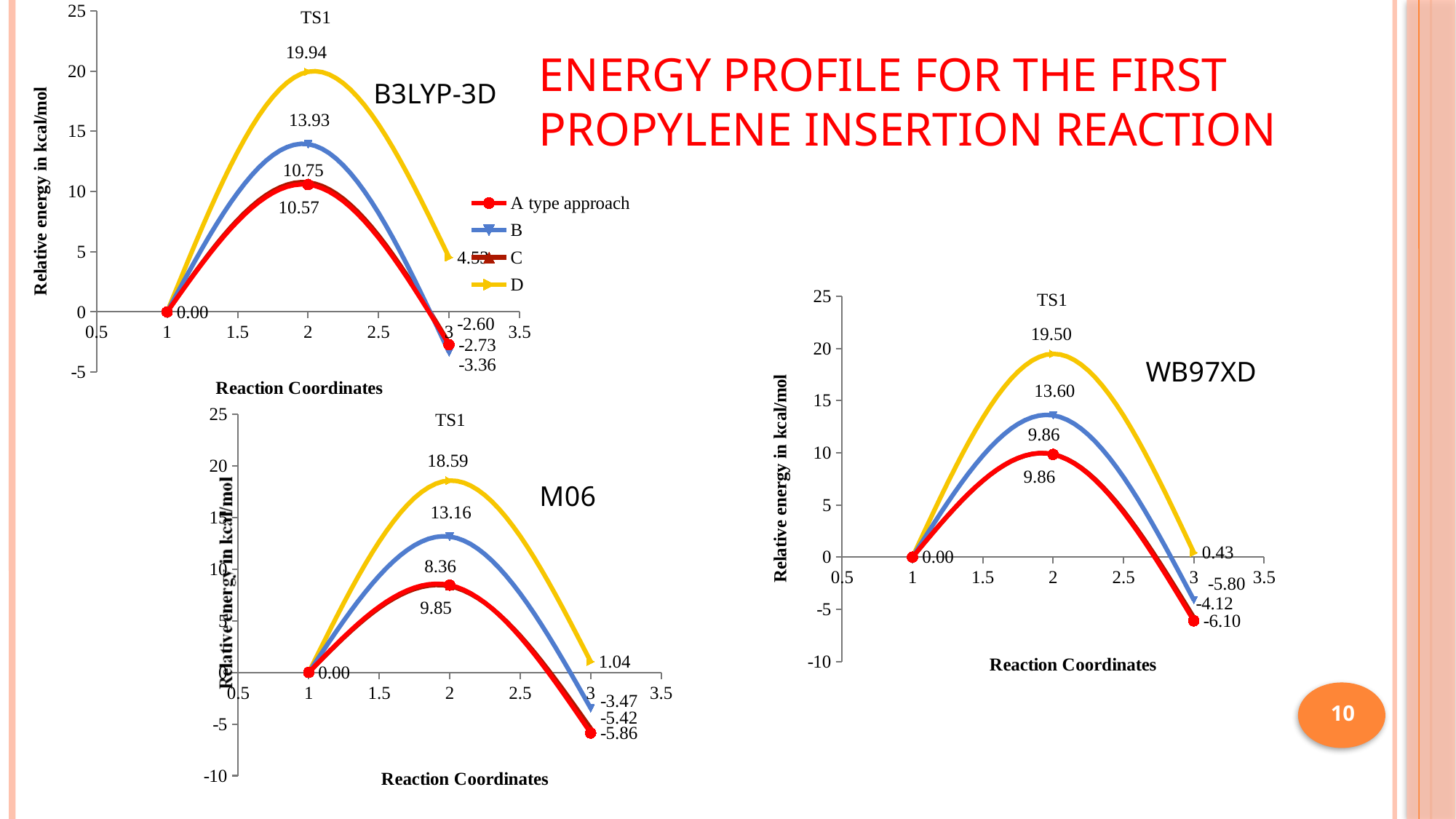
In the WB97XD chart, what is the relative energy of the D series at reaction coordinate 3? 0.43 Is the TS1 value of the D series larger in the B3LYP-3D chart or in the WB97XD chart? B3LYP-3D How many series does the legend of the B3LYP-3D chart list? 4 What kind of chart is the M06 chart? line chart In the M06 chart, what is the relative energy of the D series at reaction coordinate 3? 1.04 What is the x-axis title of the WB97XD chart? Reaction Coordinates In the B3LYP-3D chart, what is the relative energy of the D series at TS1? 19.94 In the M06 chart, which series has the highest relative energy at TS1? D In the WB97XD chart, is the value of the red A type approach series at reaction coordinate 3 greater or less than -5? less In the WB97XD chart, what is the relative energy of the B series at TS1? 13.60 In the B3LYP-3D chart, what is the difference between the D series and the B series at TS1? 6.01 In the WB97XD chart, what is the difference between the D series and the B series at TS1? 5.90